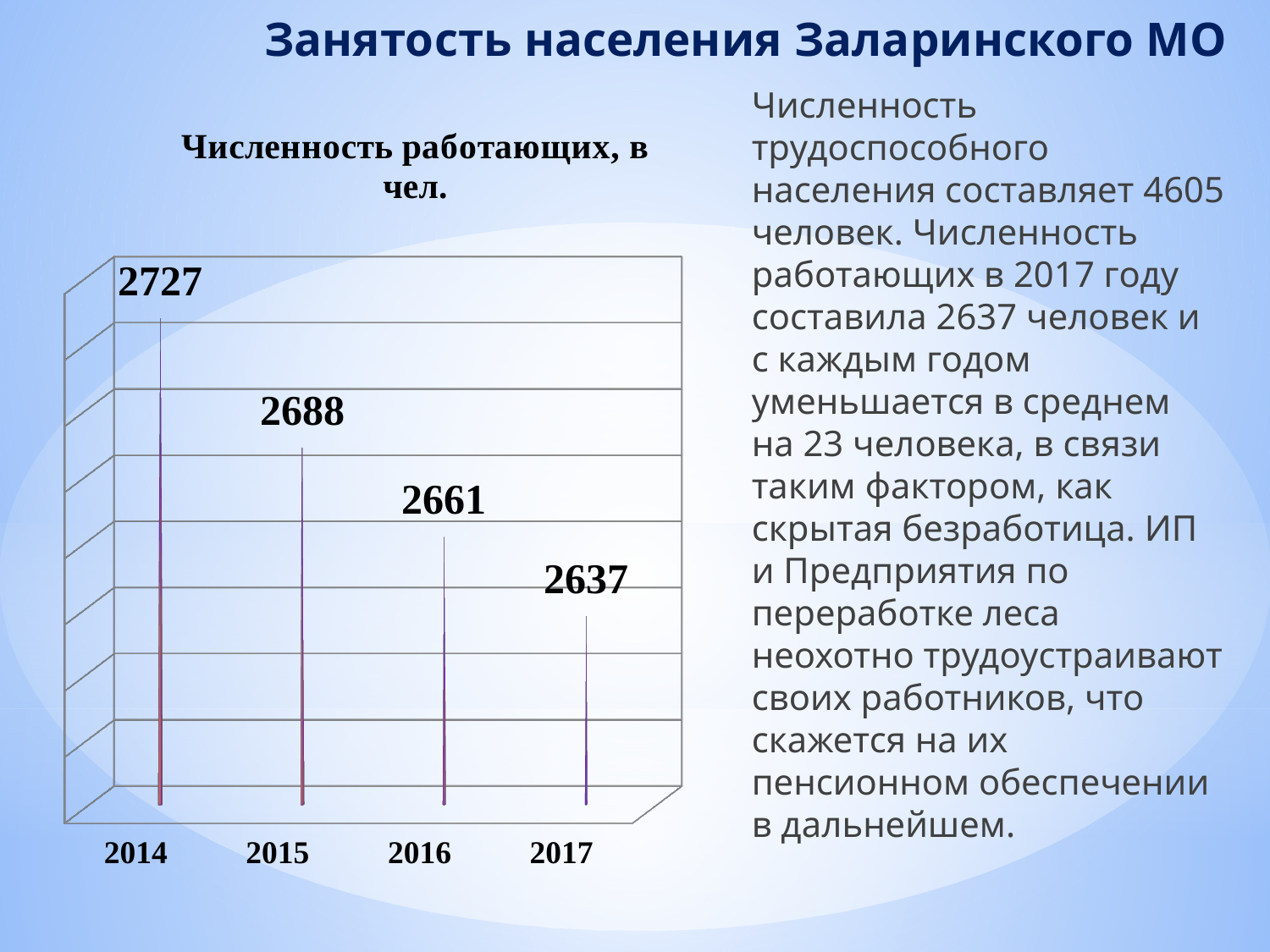
What is the difference between the values for 2015 and 2016? 27 What is the value for 2016? 2661 Which is larger, the value for 2015 or the value for 2016? 2015 Do the values rise or fall from 2014 to 2017? fall What is the difference between the values for 2014 and 2017? 90 What is the value for 2017? 2637 What kind of chart is this? bar chart Which year has the lowest number of workers? 2017 What is the value for 2015? 2688 Which year has the highest number of workers? 2014 How many years are shown on the x axis? 4 What is the value for 2014? 2727